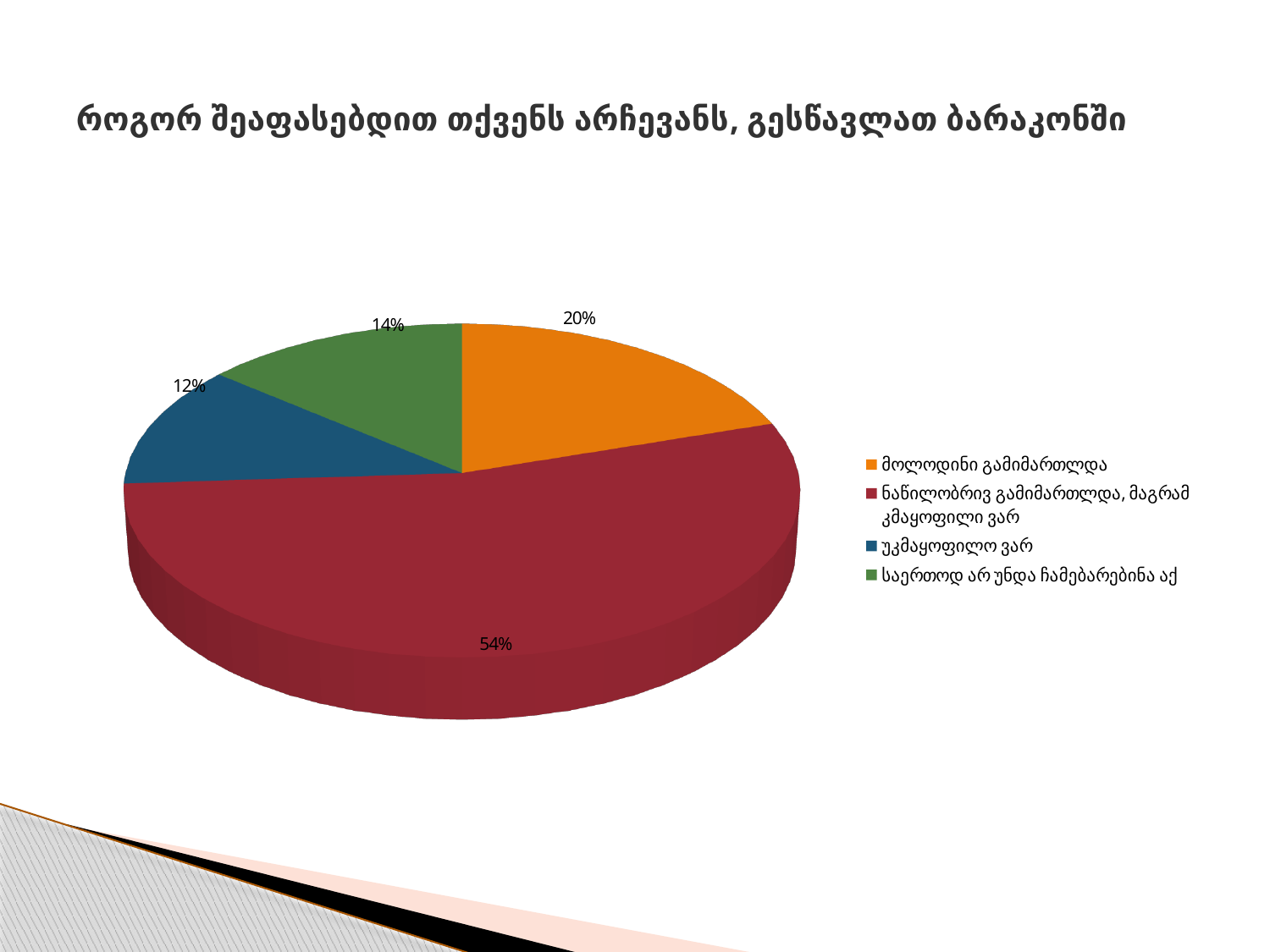
What is the title of the chart on the slide? როგორ შეაფასებდით თქვენს არჩევანს, გესწავლათ ბარაკონში What share of the pie does the slice "უკმაყოფილო ვარ" represent? 12% What colour is the slice for "უკმაყოფილო ვარ"? Blue Which category has the largest slice of the pie? ნაწილობრივ გამიმართლდა, მაგრამ კმაყოფილი ვარ What share of the pie does the slice "საერთოდ არ უნდა ჩამებარებინა აქ" represent? 14% What kind of chart is shown on the slide? Pie chart Which category has the smallest slice of the pie? უკმაყოფილო ვარ How many categories does the pie chart show? 4 What share of the pie does the slice "ნაწილობრივ გამიმართლდა, მაგრამ კმაყოფილი ვარ" represent? 54% Which slice is larger: "საერთოდ არ უნდა ჩამებარებინა აქ" or "უკმაყოფილო ვარ"? საერთოდ არ უნდა ჩამებარებინა აქ What is the difference in percentage points between the "ნაწილობრივ გამიმართლდა, მაგრამ კმაყოფილი ვარ" slice and the "მოლოდინი გამიმართლდა" slice? 34 percentage points